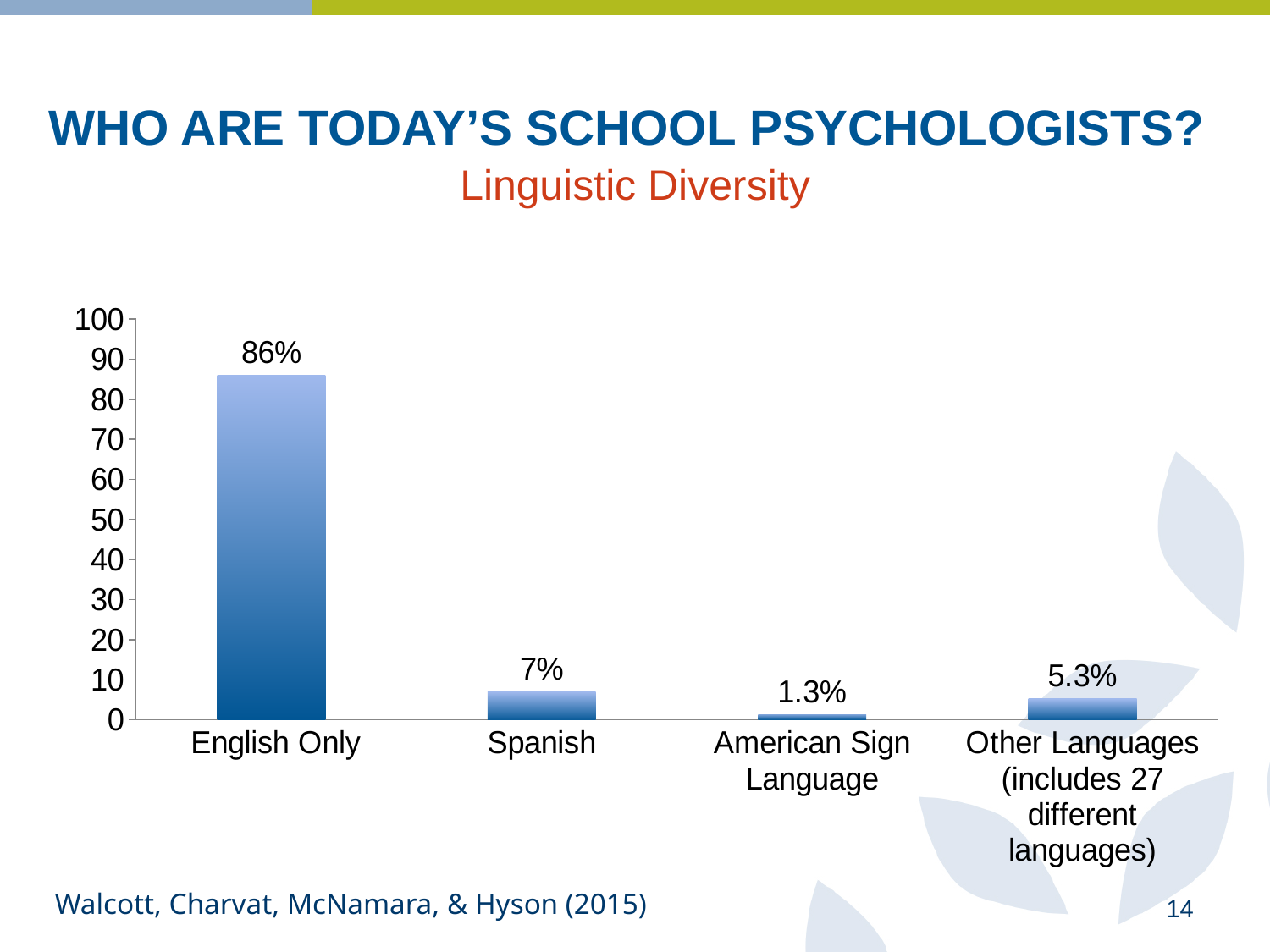
What is the value shown for Other Languages? 5.3% How many categories are shown on the x axis? 4 Which category has the lowest value? American Sign Language What is the value shown for American Sign Language? 1.3% Which is larger, the value for Spanish or the value for Other Languages? Spanish What percentage of school psychologists are English Only? 86% What is the value shown for Spanish? 7% What is the difference between the English Only and Spanish values? 79% How many different languages does the Other Languages category include, according to its label? 27 Which category has the highest value? English Only What is the difference between the Other Languages and American Sign Language values? 4% What kind of chart is shown on the slide? Bar chart